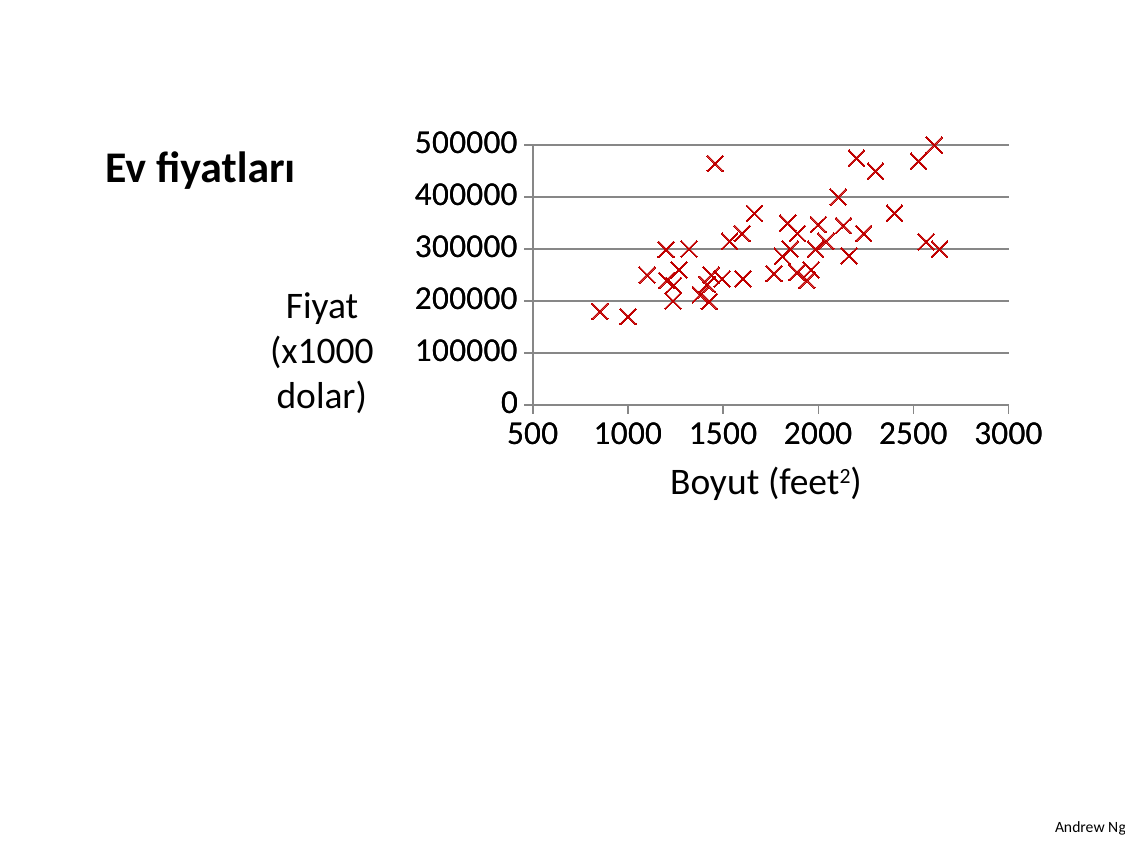
Is the highest plotted price value greater or less than 400000? greater Do the plotted prices generally rise or fall as the size (Boyut) increases along the x axis? Rise Is the lowest plotted price value greater or less than 200000? less What kind of chart is shown on the slide? Scatter plot What is the label of the x axis? Boyut (feet²) What is the title shown next to the chart? Ev fiyatları Is the price of the point with the smallest size (leftmost point) greater or less than 200000? less